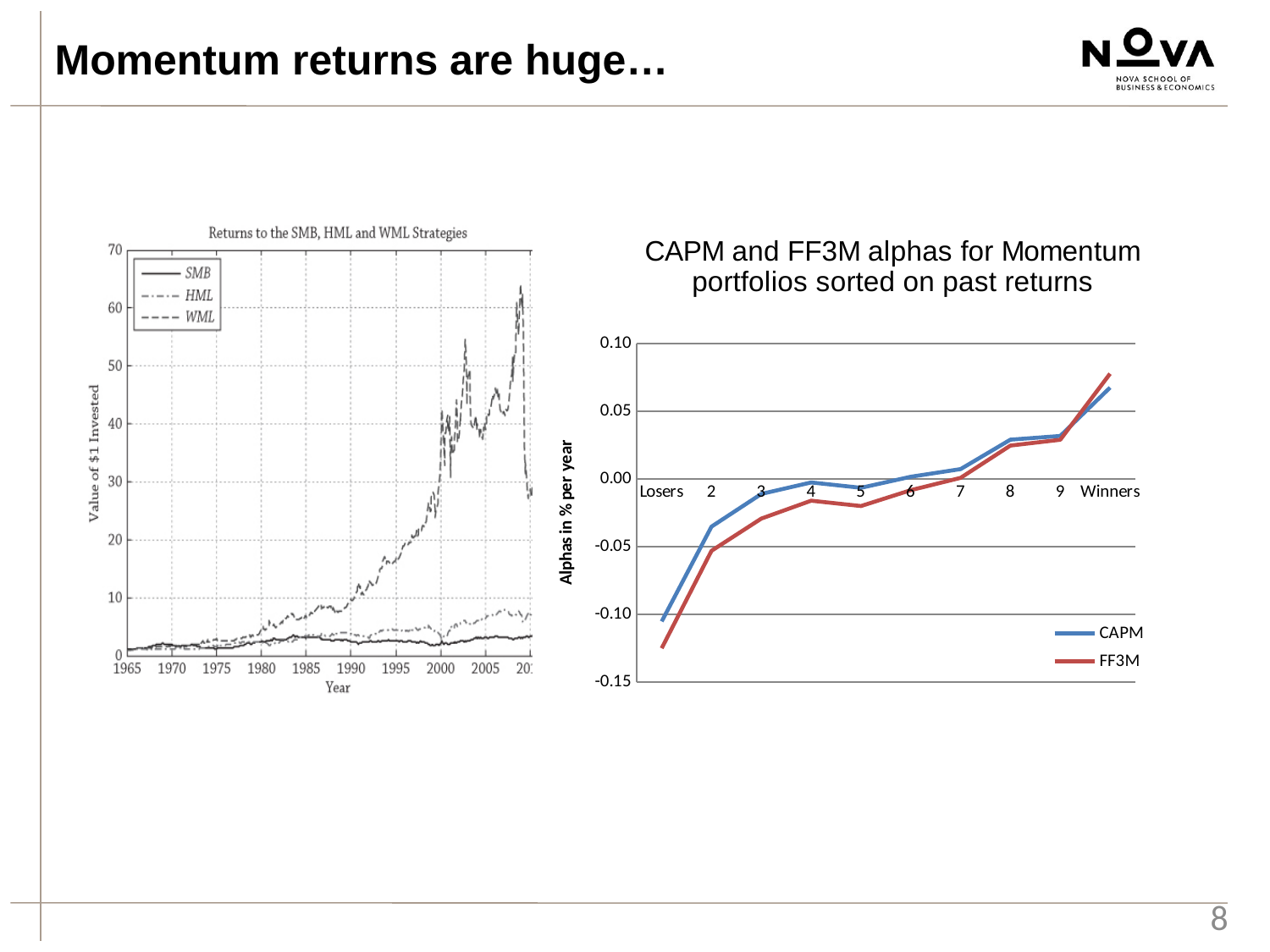
On the right chart (CAPM and FF3M alphas for Momentum portfolios), which portfolio has the highest CAPM alpha? Winners On the right chart (CAPM and FF3M alphas for Momentum portfolios), how many series does the legend list? 2 On the left chart (Returns to the SMB, HML and WML Strategies), which strategy reaches the highest value of $1 invested? WML What kind of chart is the left chart (Returns to the SMB, HML and WML Strategies)? line chart On the right chart (CAPM and FF3M alphas for Momentum portfolios), is the CAPM alpha for Winners greater or less than 0.05? greater On the right chart (CAPM and FF3M alphas for Momentum portfolios), for the Losers portfolio, which series has the higher alpha, CAPM or FF3M? CAPM On the right chart (CAPM and FF3M alphas for Momentum portfolios), do the alphas generally rise or fall moving from Losers to Winners? rise On the right chart (CAPM and FF3M alphas for Momentum portfolios), how many portfolio categories are shown on the x axis? 10 On the right chart (CAPM and FF3M alphas for Momentum portfolios), is the FF3M alpha for Losers greater or less than -0.10? less On the right chart (CAPM and FF3M alphas for Momentum portfolios), for the Winners portfolio, which series has the higher alpha, CAPM or FF3M? FF3M On the right chart (CAPM and FF3M alphas for Momentum portfolios), which portfolio has the lowest FF3M alpha? Losers On the left chart (Returns to the SMB, HML and WML Strategies), how many strategies does the legend list? 3